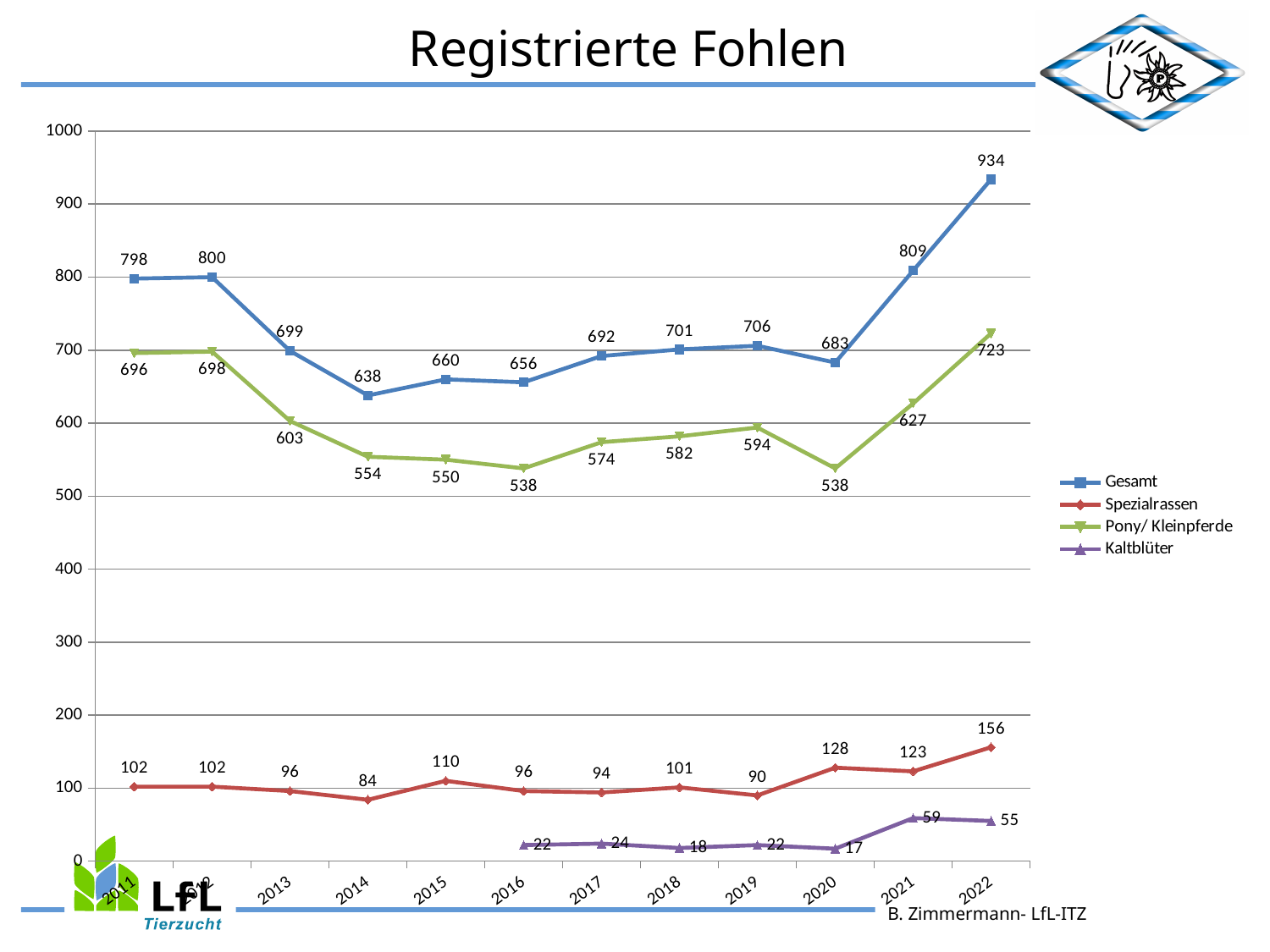
In which year is the Gesamt series lowest? 2014 What is the Pony/ Kleinpferde value for 2016? 538 In which year is the Spezialrassen series highest? 2022 What is the difference between the Gesamt values for 2022 and 2021? 125 In which year is the Gesamt series highest? 2022 What is the Spezialrassen value for 2015? 110 Does the Gesamt series rise or fall from 2020 to 2022? rise How many series does the legend list? 4 Which year has the larger Kaltblüter value, 2021 or 2022? 2021 What is the Gesamt value for 2022? 934 What is the Kaltblüter value for 2021? 59 What kind of chart is shown on the slide? line chart